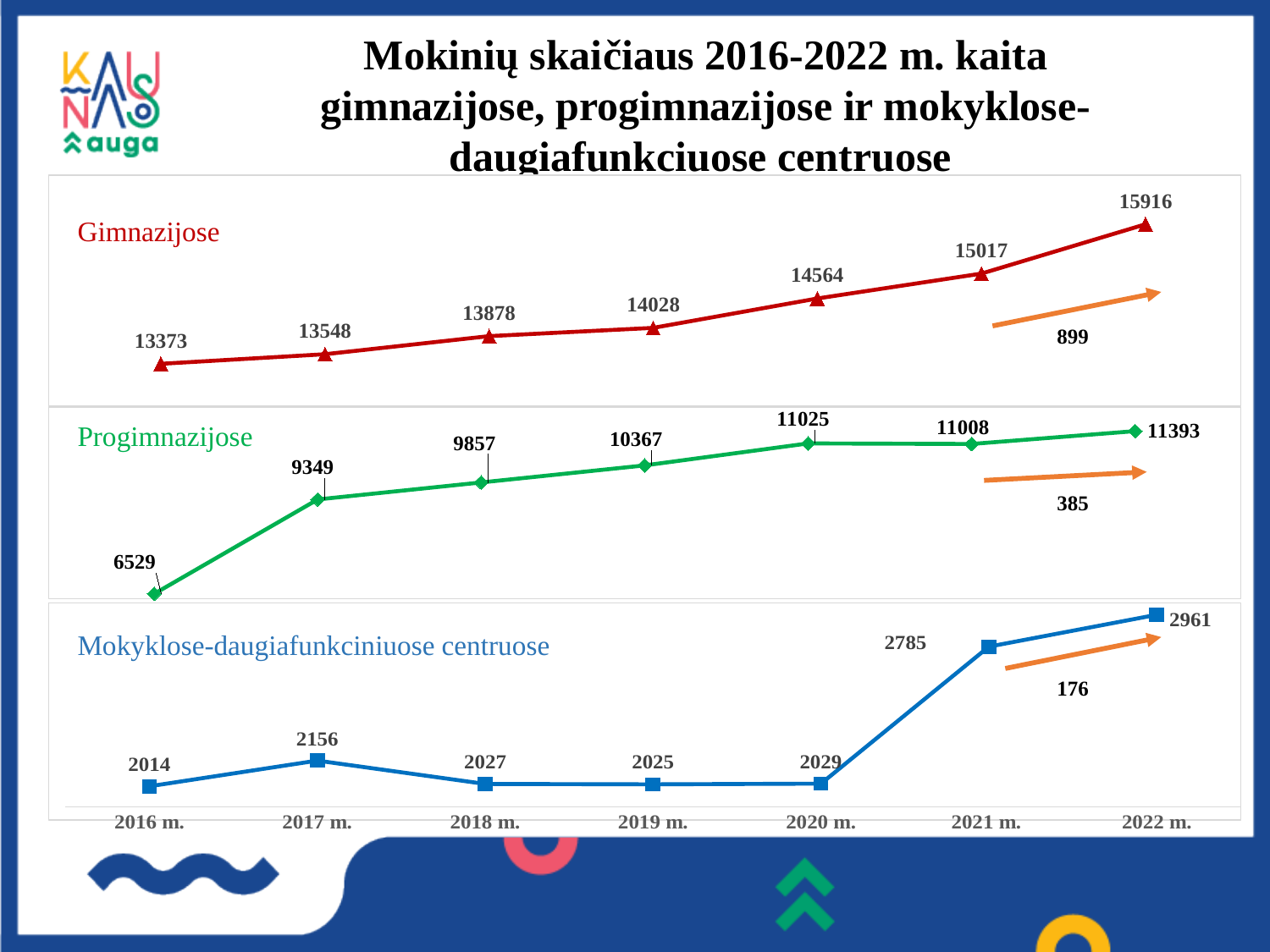
In the Mokyklose-daugiafunkciniuose centruose chart, which year has the highest value? 2022 m. In the Mokyklose-daugiafunkciniuose centruose chart, what is the value for 2021 m.? 2785 In the Progimnazijose chart, what is the value for 2016 m.? 6529 In the Progimnazijose chart, what is the difference between the values for 2017 m. and 2016 m.? 2820 What number is shown next to the orange arrow in the Mokyklose-daugiafunkciniuose centruose chart? 176 In the Gimnazijose chart, which year has the lowest value? 2016 m. In the Gimnazijose chart, what is the difference between the values for 2022 m. and 2021 m.? 899 What kind of chart is the Progimnazijose chart? Line chart In the Gimnazijose chart, do the values rise or fall from 2016 m. to 2022 m.? Rise In the Gimnazijose chart, what is the value for 2022 m.? 15916 How many years are plotted along the x axis of the Gimnazijose chart? 7 In the Progimnazijose chart, which is larger, the value for 2020 m. or the value for 2021 m.? 2020 m.